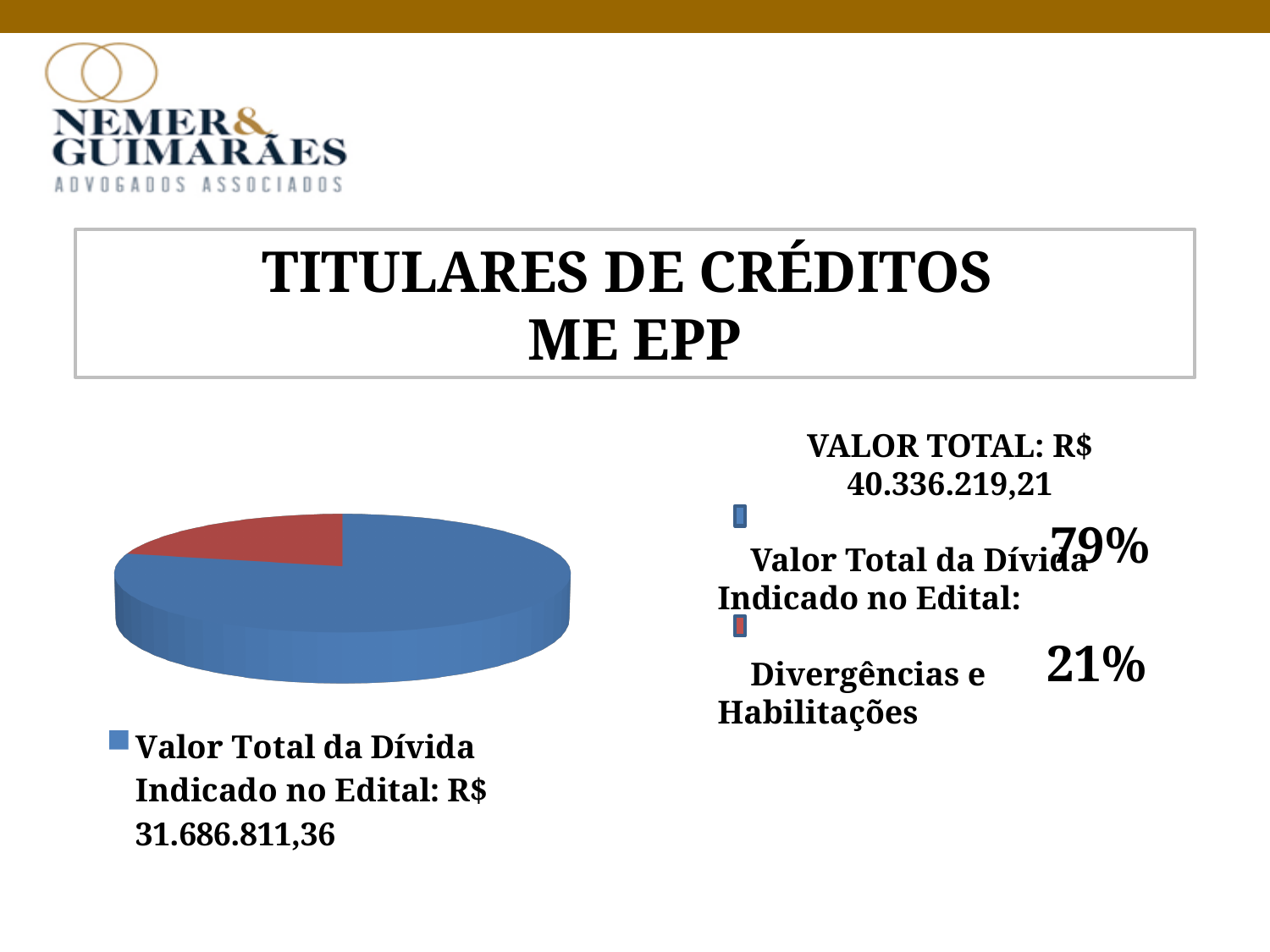
What share of the pie does "Valor Total da Dívida Indicado no Edital" represent? 79% What colour is the slice for "Divergências e Habilitações"? red What share of the pie does "Divergências e Habilitações" represent? 21% What is the difference in percentage points between the 79% slice and the 21% slice? 58 percentage points How many slices does the pie chart have? 2 Which slice of the pie is the largest? Valor Total da Dívida Indicado no Edital What kind of chart is shown on the slide? pie chart What value is given in the legend for "Valor Total da Dívida Indicado no Edital"? R$ 31.686.811,36 Which is larger, the share for "Valor Total da Dívida Indicado no Edital" or the share for "Divergências e Habilitações"? Valor Total da Dívida Indicado no Edital What total value is stated in the chart title? R$ 40.336.219,21 Which slice of the pie is the smallest? Divergências e Habilitações